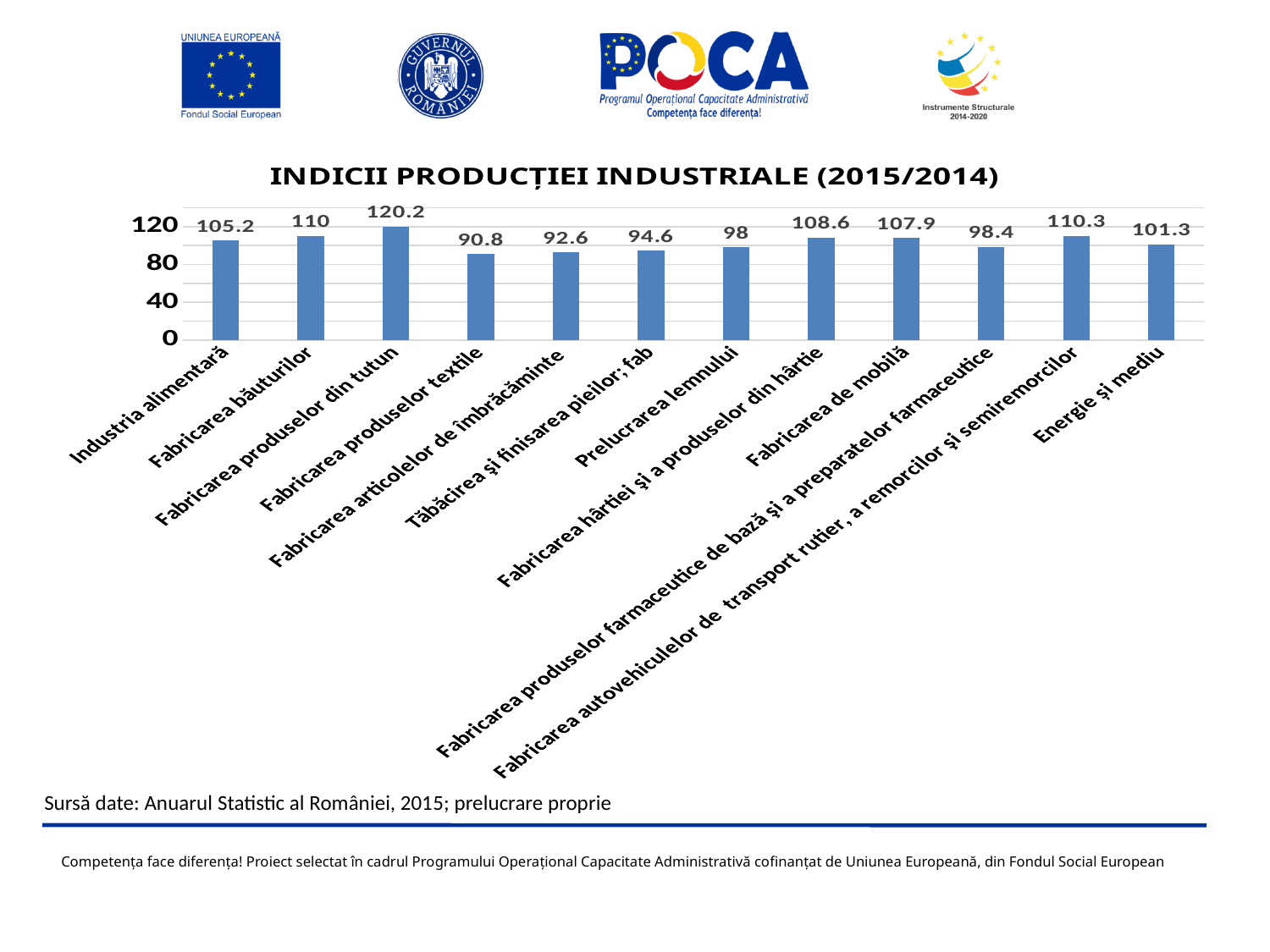
What is the value for Fabricarea produselor textile? 90.8 What is the value for Industria alimentară? 105.2 Which category has the highest value? Fabricarea produselor din tutun How many categories are shown in the chart? 12 What kind of chart is shown on the slide? Bar chart Which is larger, the value for Fabricarea băuturilor or the value for Fabricarea de mobilă? Fabricarea băuturilor What is the value for Energie și mediu? 101.3 Is the value for Fabricarea articolelor de îmbrăcăminte greater or less than 80? greater What is the value for Prelucrarea lemnului? 98 What is the difference between the values for Fabricarea produselor din tutun and Fabricarea produselor textile? 29.4 What is the title of the chart? INDICII PRODUCȚIEI INDUSTRIALE (2015/2014) Which category has the lowest value? Fabricarea produselor textile